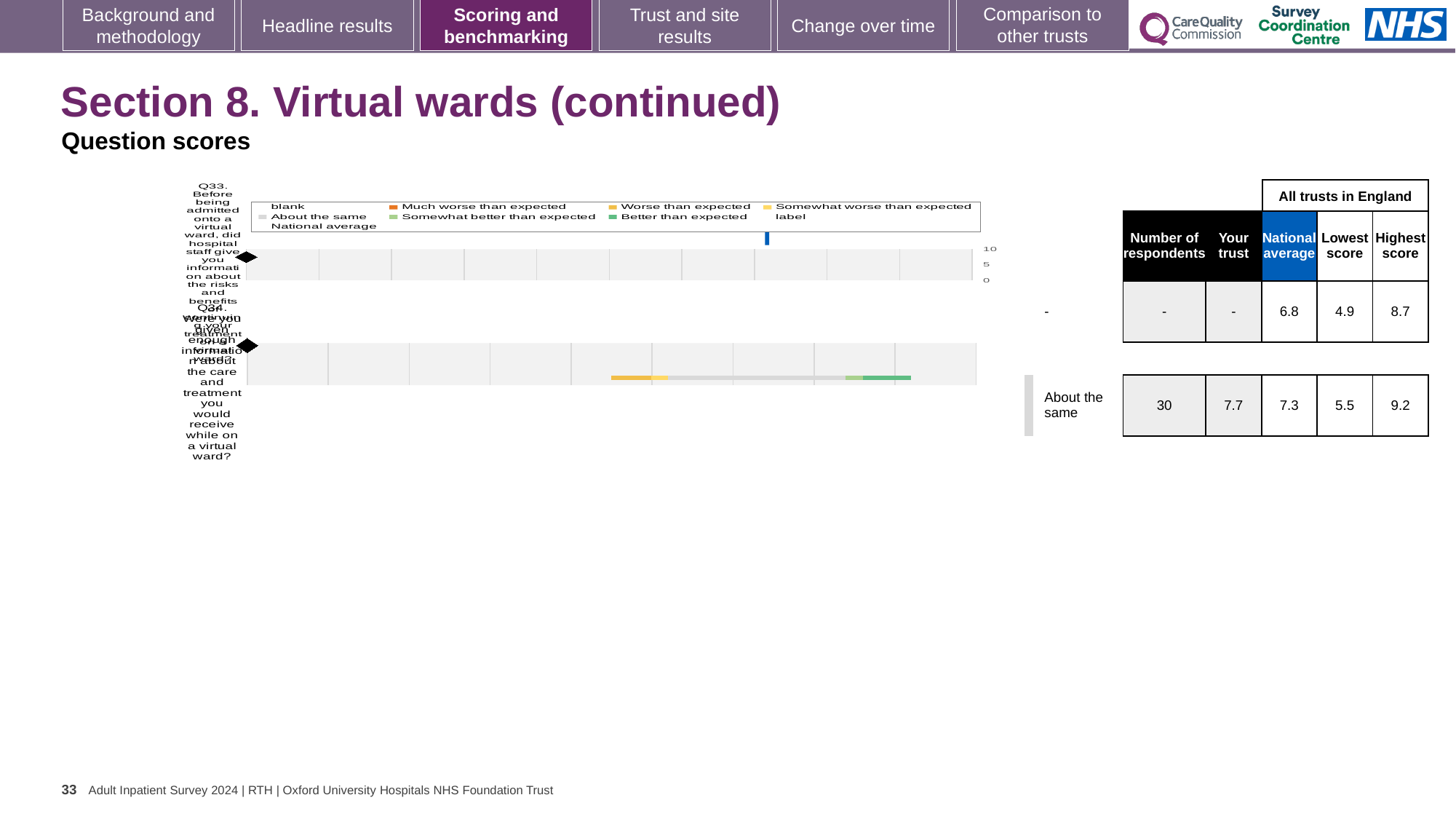
What is the maximum value shown on the chart's x axis? 10 What benchmarking category is shown for Q34? About the same What is the difference between the highest score and the lowest score for Q33? 3.8 How many respondents answered Q34? 30 What is the national average score for Q33? 6.8 What kind of chart is shown on the slide? bar chart What is the 'Your trust' score for Q34? 7.7 Which question has the higher national average, Q33 or Q34? Q34 What is the difference between the highest score and the lowest score for Q34? 3.7 What is the national average score for Q34? 7.3 For Q34, which is higher: the trust's score or the national average? Your trust (7.7) How many questions are plotted in the chart? 2